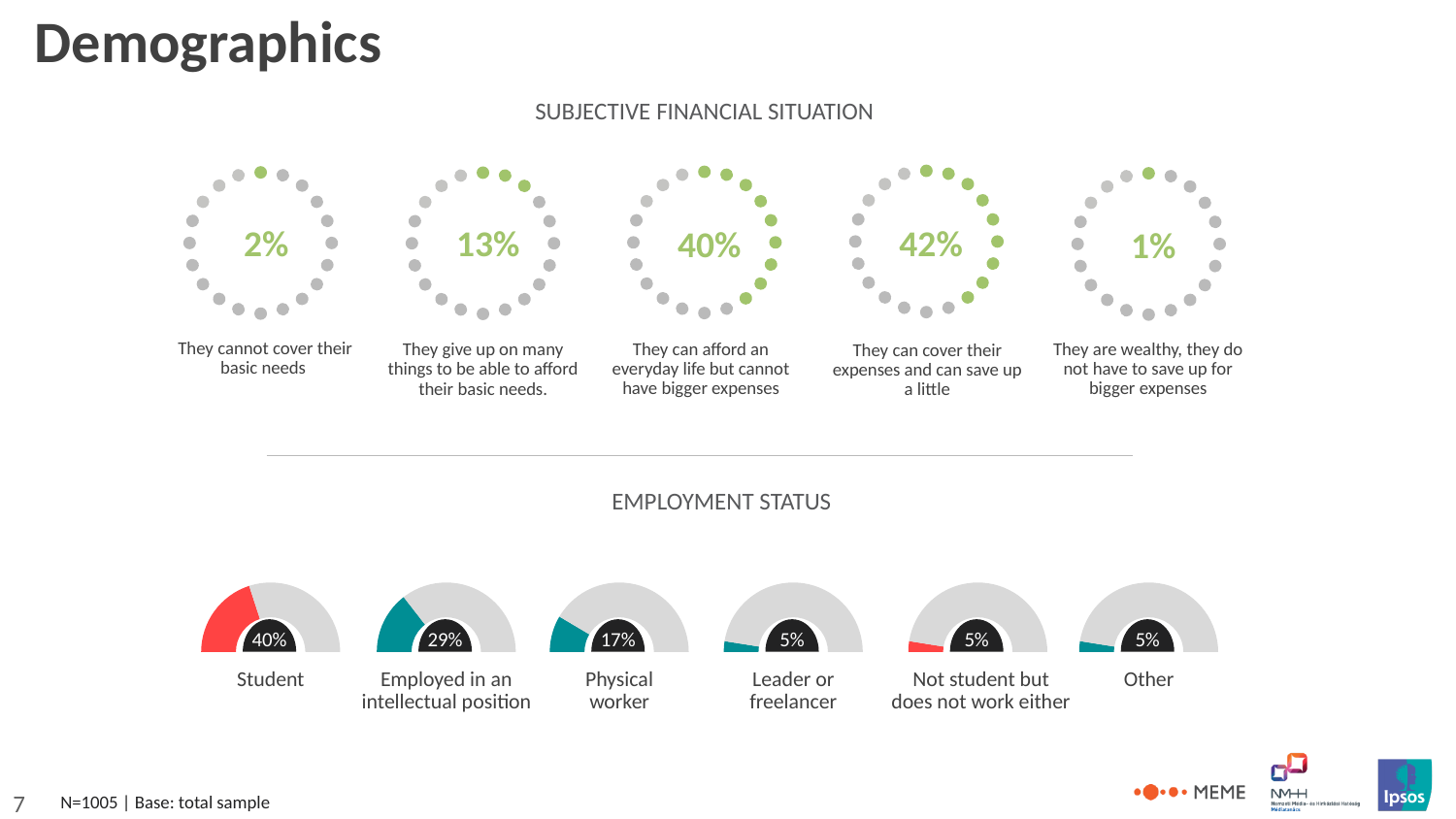
In the Subjective Financial Situation chart, what is the difference between the share who can cover expenses and save a little and the share who can afford everyday life but not bigger expenses? 2 percentage points In the Subjective Financial Situation chart, what percentage say they cannot cover their basic needs? 2% In the Subjective Financial Situation chart, what percentage say they give up on many things to be able to afford their basic needs? 13% In the Employment Status chart, what percentage are employed in an intellectual position? 29% In the Subjective Financial Situation chart, what percentage of respondents say they can cover their expenses and can save up a little? 42% In the Subjective Financial Situation chart, which category has the highest percentage? They can cover their expenses and can save up a little In the Employment Status chart, which is larger: Physical worker or Employed in an intellectual position? Employed in an intellectual position How many categories are shown in the Employment Status chart? 6 In the Subjective Financial Situation chart, which category has the lowest percentage? They are wealthy, they do not have to save up for bigger expenses In the Employment Status chart, which category has the highest percentage? Student In the Employment Status chart, what percentage of respondents are students? 40% How many categories are shown in the Subjective Financial Situation chart? 5